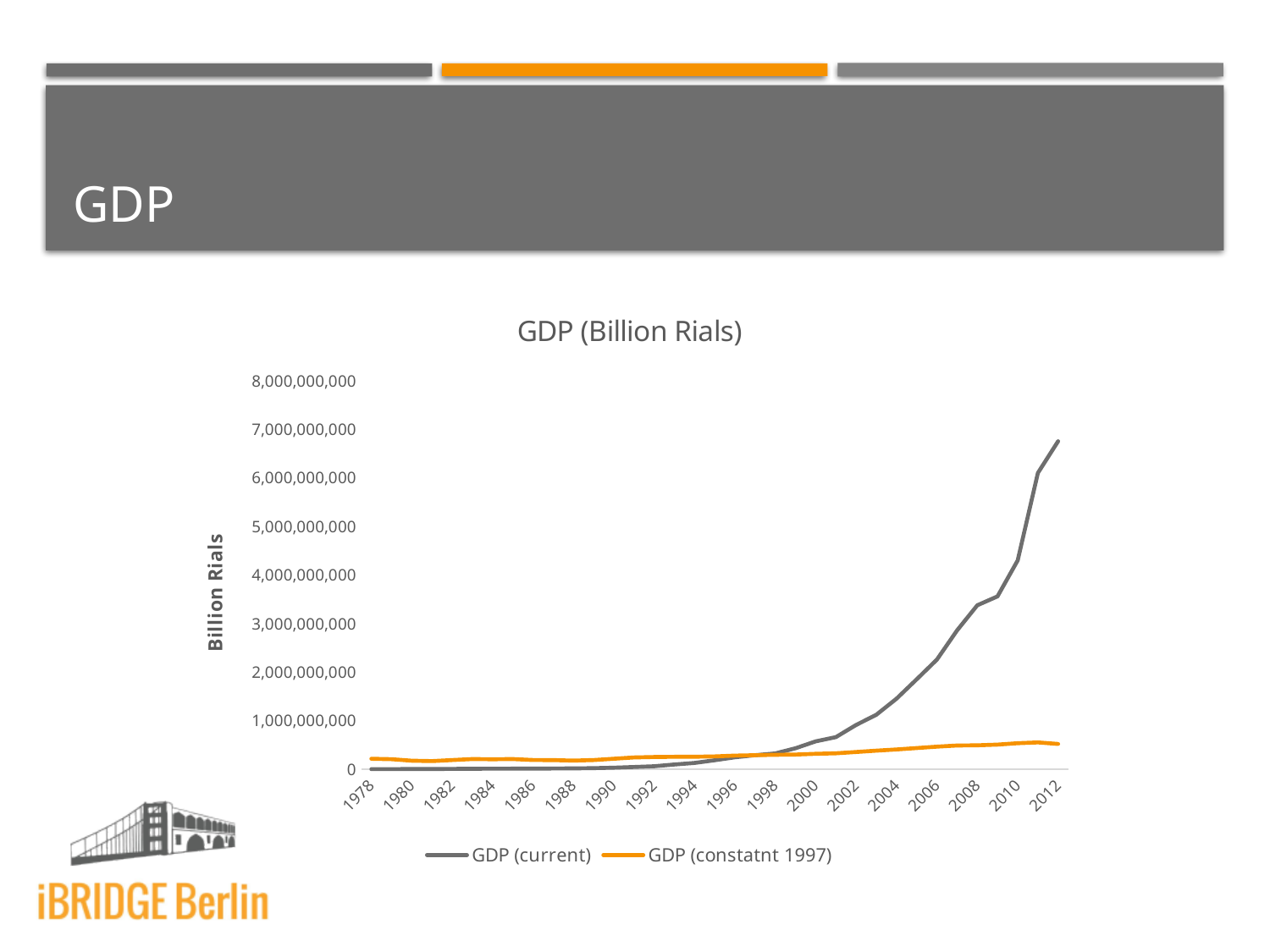
What is the title of the chart on the slide? GDP (Billion Rials) What are the two series named in the legend of the GDP chart? GDP (current) and GDP (constatnt 1997) In 2012, which series has the larger value, GDP (current) or GDP (constatnt 1997)? GDP (current) Is the value of GDP (current) in 2012 greater or less than 6,000,000,000? greater Is the value of GDP (constatnt 1997) in 2012 greater or less than 1,000,000,000? less Is the value of GDP (current) in 2008 greater or less than 3,000,000,000? greater In 1980, which series has the larger value, GDP (current) or GDP (constatnt 1997)? GDP (constatnt 1997) Does GDP (current) generally rise or fall from 1978 to 2012? rise How many series does the legend of the GDP chart list? 2 What kind of chart is shown on the slide? line chart In which year does GDP (current) reach its highest value? 2012